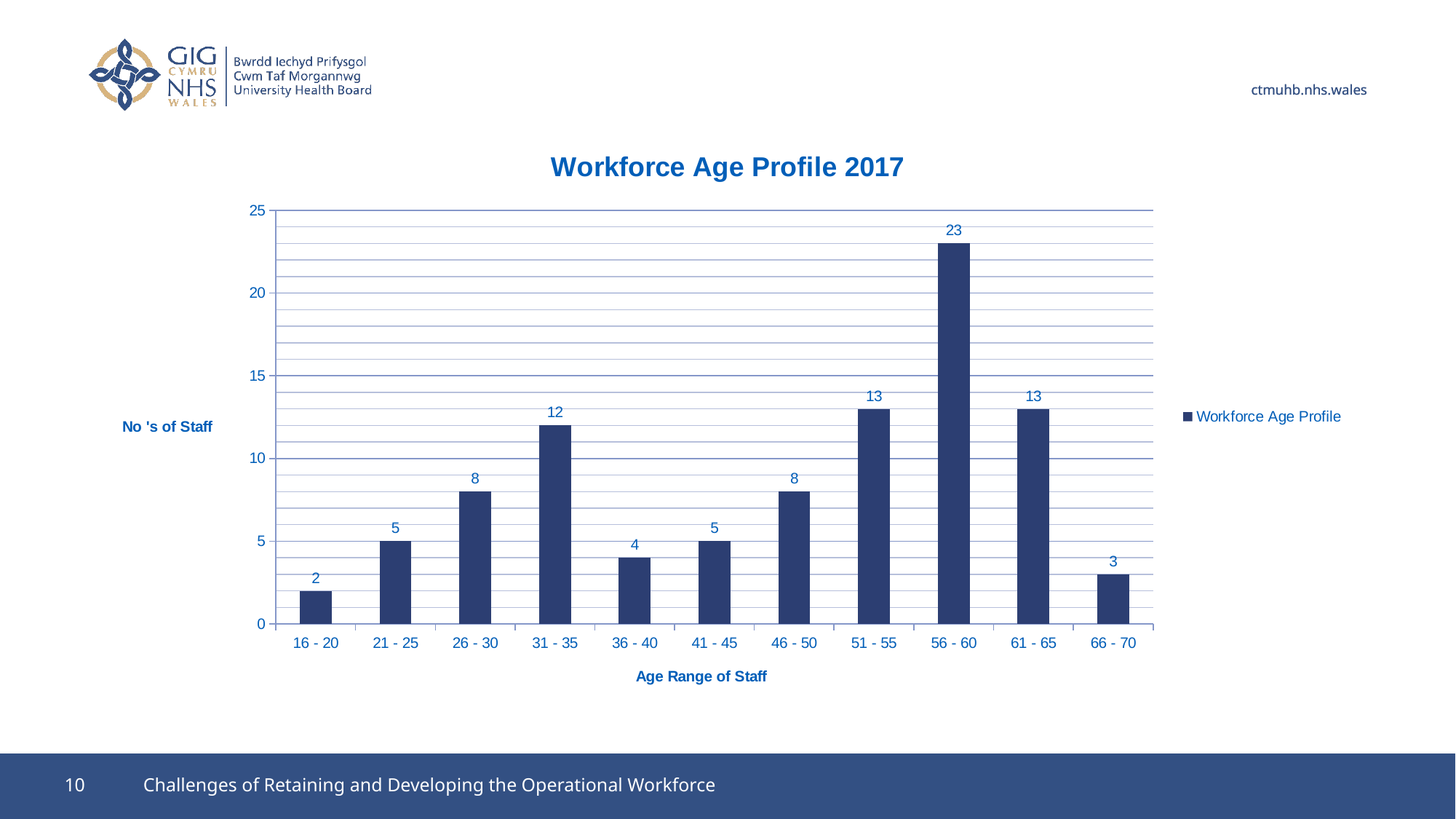
What is the title of the chart? Workforce Age Profile 2017 Which age range has more staff, 26 - 30 or 36 - 40? 26 - 30 What is the number of staff in the 56 - 60 age range? 23 How many series does the legend list? 1 Is the value for the 51 - 55 age range greater or less than 10? greater What is the number of staff in the 16 - 20 age range? 2 What kind of chart is shown on the slide? Bar chart What is the difference in number of staff between the 56 - 60 and 61 - 65 age ranges? 10 What is the number of staff in the 31 - 35 age range? 12 Which age range has the highest number of staff? 56 - 60 How many age ranges are shown on the x axis? 11 Which age range has the lowest number of staff? 16 - 20